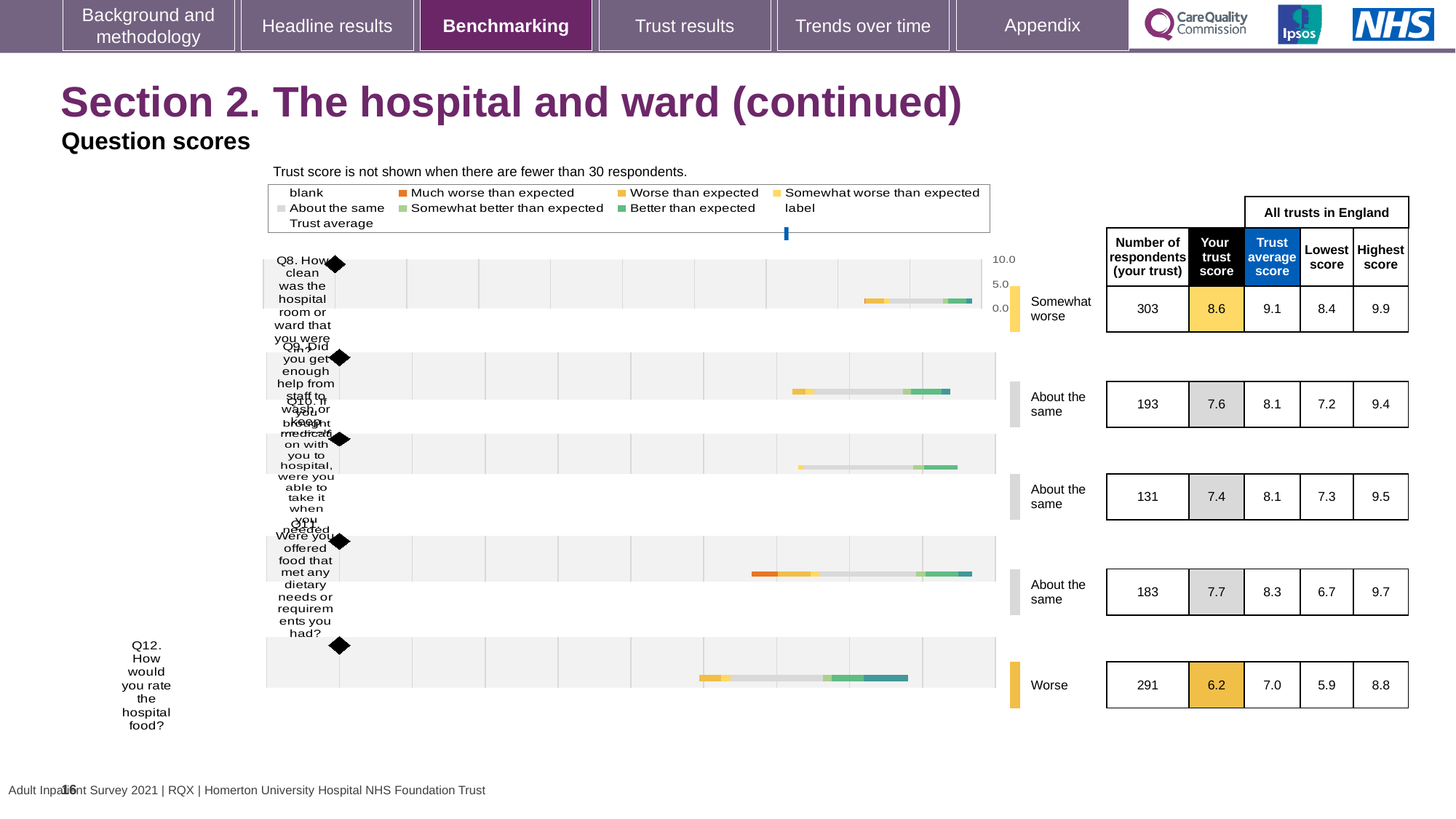
What kind of chart is used to show the question scores on this slide? Bar chart Which has the higher trust score, Q9 or Q10? Q9 According to the note above the chart, below how many respondents is the trust score not shown? 30 How many questions are plotted in the question scores chart? 5 What benchmark category is Q12 rated as? Worse What is the difference between the highest and lowest scores for Q12? 2.9 What is the trust score for Q12 (How would you rate the hospital food?)? 6.2 Which question has the highest trust score? Q8 Which question has the lowest trust score? Q12 What is the difference between the trust average score and the trust score for Q8? 0.5 What is the highest score across all trusts in England for Q8? 9.9 How many respondents answered Q8 (How clean was the hospital room or ward)? 303